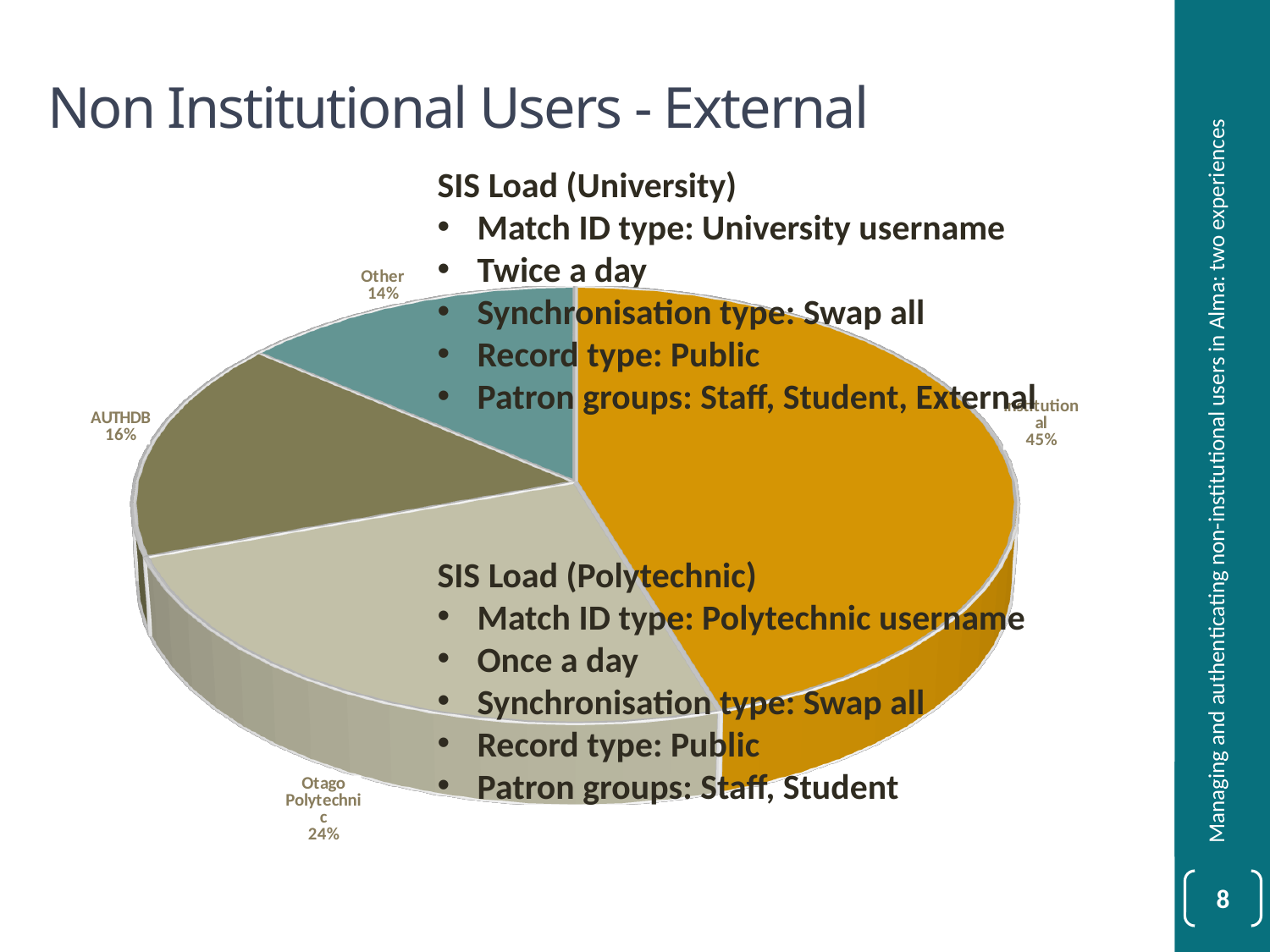
What share of the pie does the Institutional slice represent? 45% What share of the pie does AUTHDB represent? 16% What kind of chart is shown on the slide? pie chart Which slice of the pie is the largest? Institutional What share of the pie does the Other slice represent? 14% How many slices does the pie chart have? 4 Which slice of the pie is the smallest? Other What colour is the Institutional slice of the pie? orange Which is larger, the AUTHDB slice or the Other slice? AUTHDB What is the difference in percentage points between the Otago Polytechnic slice and the AUTHDB slice? 8 What is the difference in percentage points between the Institutional slice and the Otago Polytechnic slice? 21